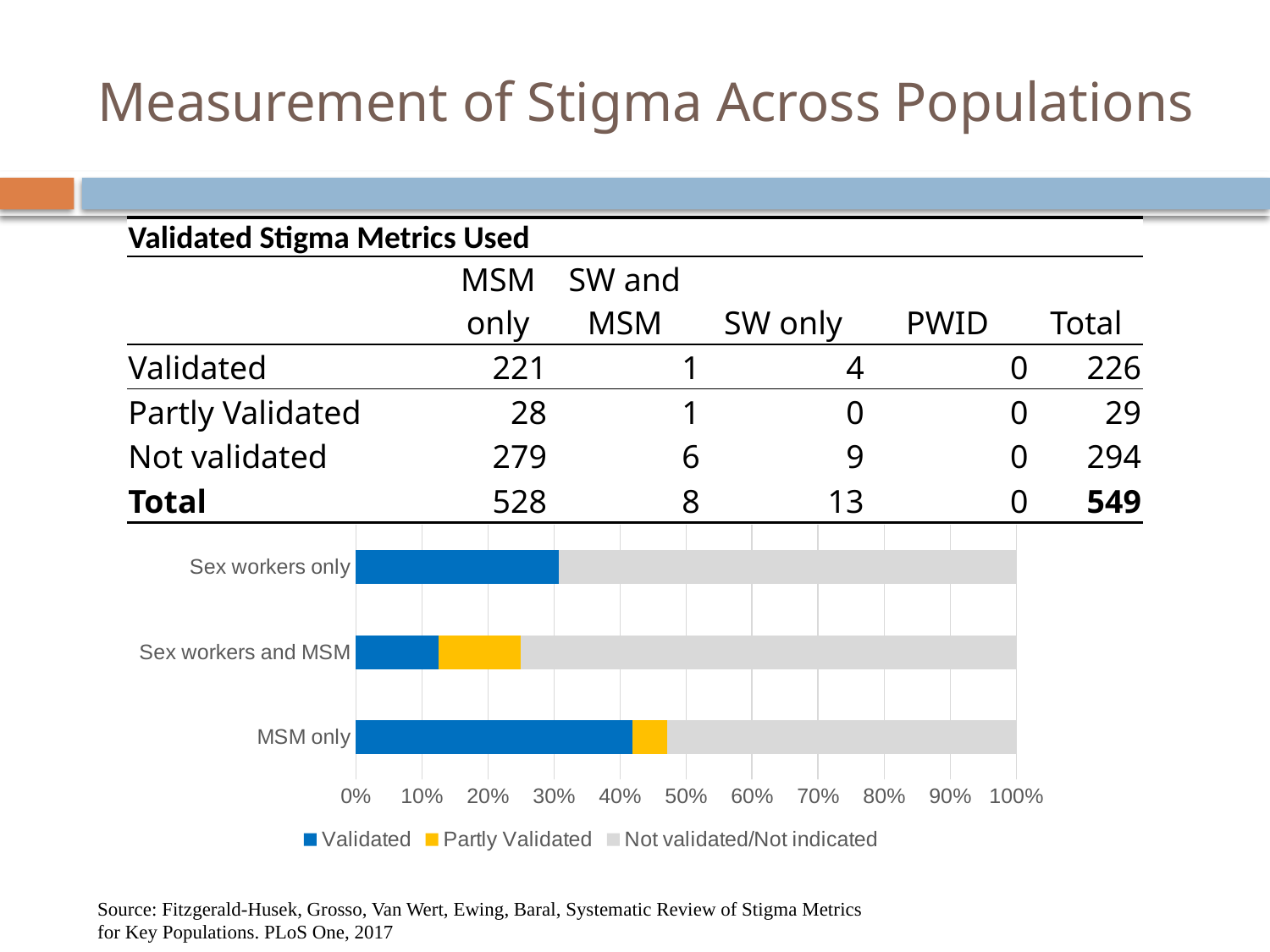
What colour represents the Partly Validated series in the chart? Yellow Is the Validated share for Sex workers only greater or less than 40%? less How many categories are plotted on the chart's vertical axis? 3 Which category in the chart shows no Partly Validated segment? Sex workers only Is the Validated share for MSM only greater or less than 30%? greater Which has the larger Validated share: MSM only or Sex workers only? MSM only Which category has the largest Validated share in the chart? MSM only How many series does the chart legend list? 3 What kind of chart is shown on the slide? Stacked bar chart Is the Validated share for Sex workers only greater or less than 20%? greater Which category has the smallest Validated share in the chart? Sex workers and MSM